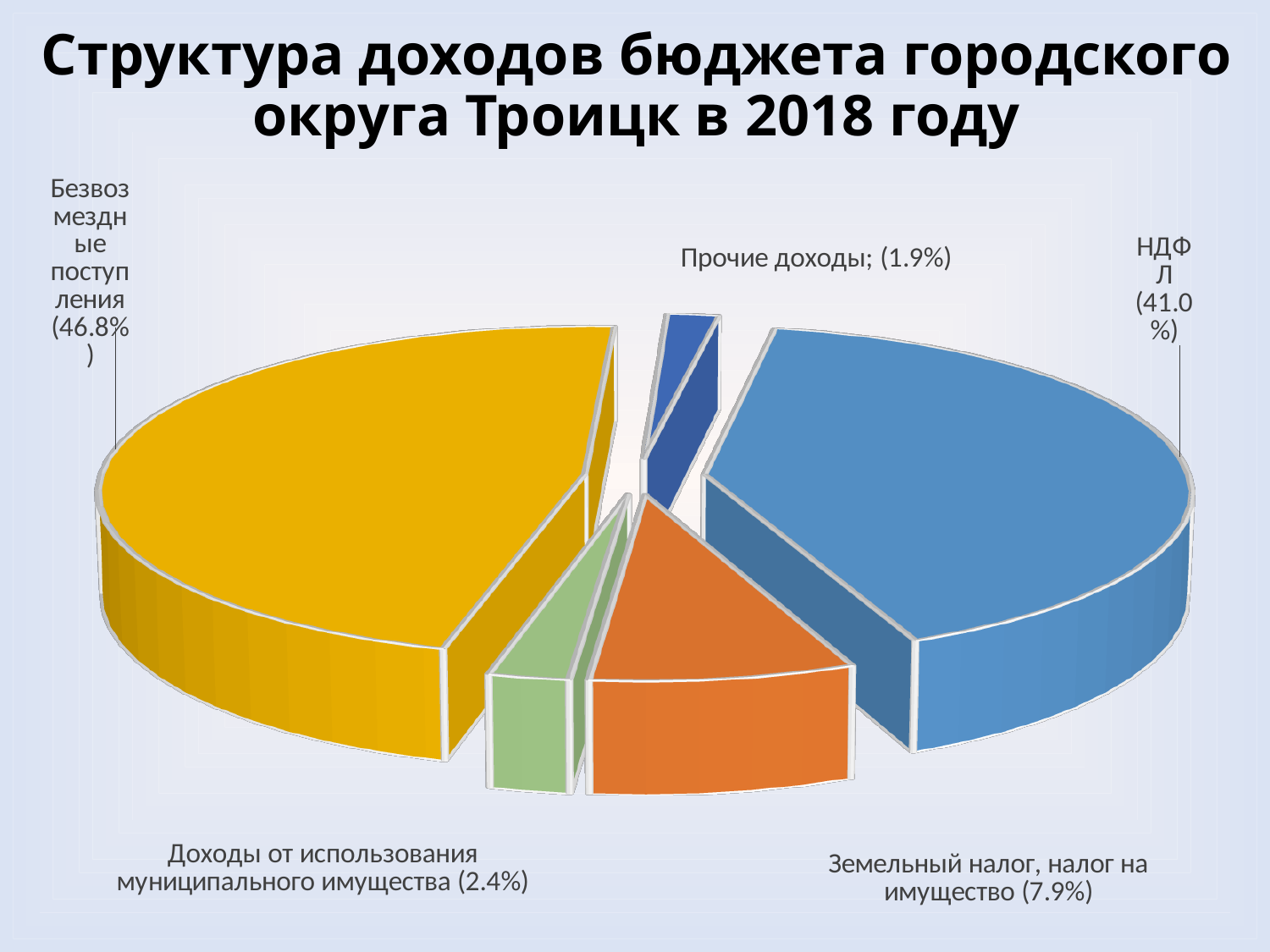
How many slices does the pie chart have? 5 What kind of chart is shown on the slide? Pie chart What share of the pie does Прочие доходы have? 1.9% What is the difference in share between Безвозмездные поступления and НДФЛ? 5.8% Which category has the smallest share of the pie? Прочие доходы What is the title of the chart? Структура доходов бюджета городского округа Троицк в 2018 году What share of the pie does Земельный налог, налог на имущество have? 7.9% What share of the pie does Доходы от использования муниципального имущества have? 2.4% Which is larger: the share of Земельный налог, налог на имущество or the share of Доходы от использования муниципального имущества? Земельный налог, налог на имущество Which category has the largest share of the pie? Безвозмездные поступления